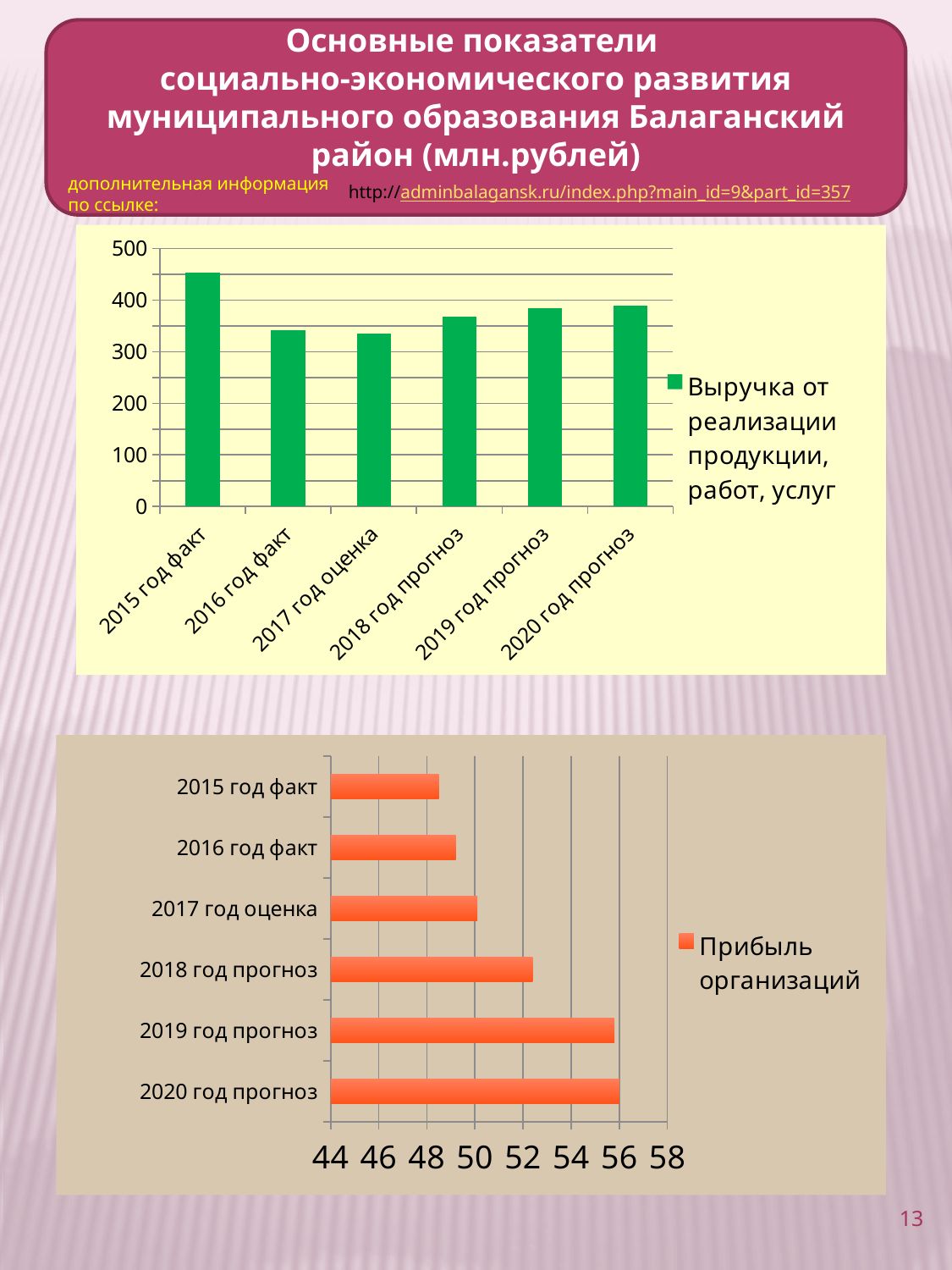
In the bottom chart (Прибыль организаций), which is larger: the value for 2018 год прогноз or 2016 год факт? 2018 год прогноз In the bottom chart (Прибыль организаций), is the value for 2018 год прогноз greater or less than 52? greater In the top chart (Выручка от реализации продукции, работ, услуг), is the value for 2016 год факт greater or less than 400? less What type of chart is the bottom chart (Прибыль организаций)? bar chart In the top chart (Выручка от реализации продукции, работ, услуг), is the value for 2015 год факт greater or less than 400? greater In the top chart (Выручка от реализации продукции, работ, услуг), which category has the highest value? 2015 год факт In the bottom chart (Прибыль организаций), do the values rise or fall from 2015 год факт to 2020 год прогноз? rise What type of chart is the top chart (Выручка от реализации продукции, работ, услуг)? bar chart In the top chart (Выручка от реализации продукции, работ, услуг), which is larger: the value for 2015 год факт or 2020 год прогноз? 2015 год факт How many categories are shown in the top chart (Выручка от реализации продукции, работ, услуг)? 6